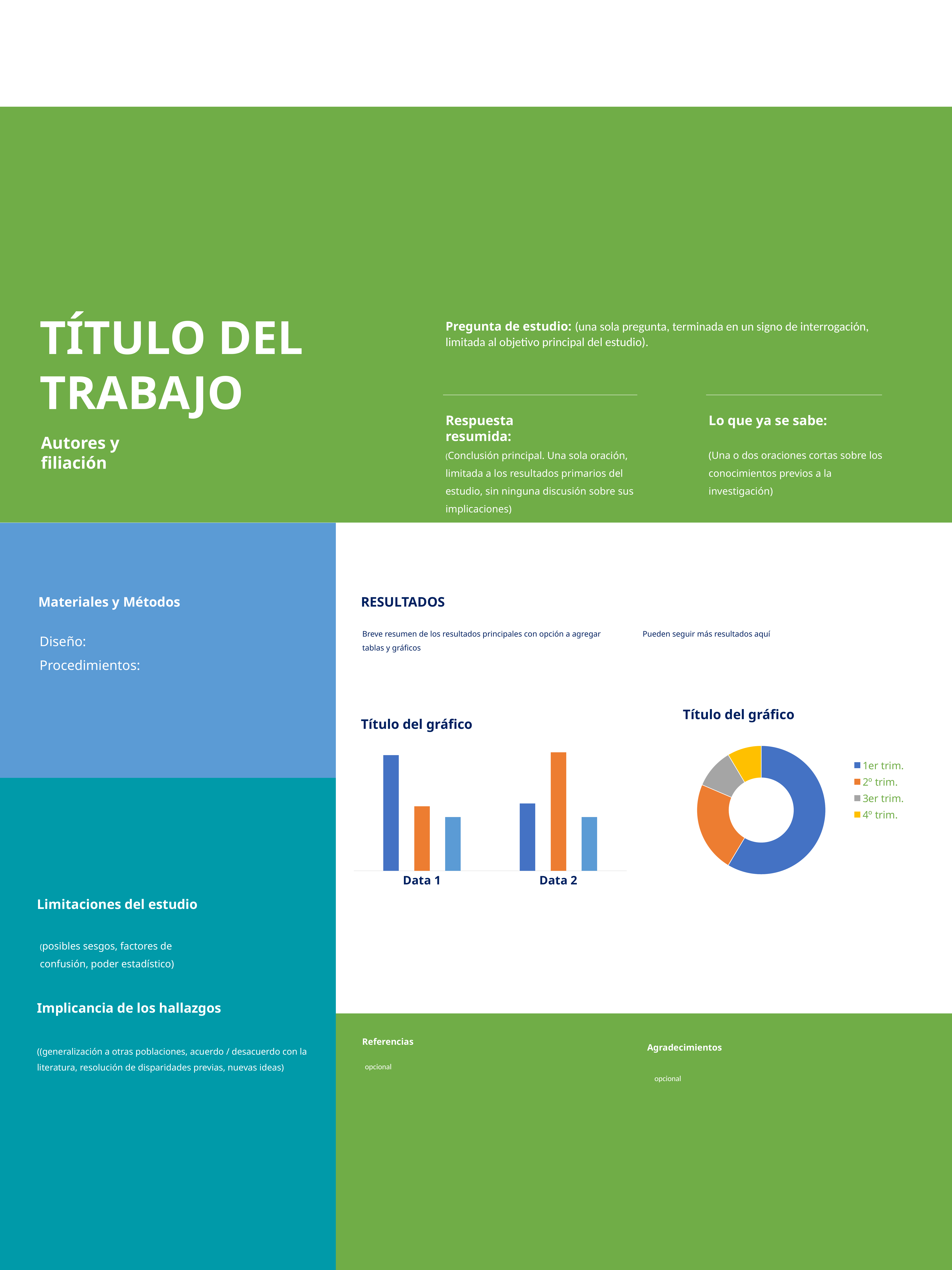
In the doughnut chart on the right, which legend entry has the largest slice? 1er trim. What kind of chart is the chart on the right of the Resultados section? doughnut chart What kind of chart is the chart on the left of the Resultados section? bar chart In the bar chart on the left, is the first (dark blue) bar taller for Data 1 or for Data 2? Data 1 In the bar chart on the left, which bar is tallest within Data 1: the first, second or third? the first In the doughnut chart on the right, which legend entry has the smallest slice? 4º trim. In the bar chart on the left, is the second (orange) bar taller for Data 1 or for Data 2? Data 2 In the doughnut chart on the right, which slice is larger: 2º trim. or 3er trim.? 2º trim. In the bar chart on the left, which category contains the tallest bar overall? Data 2 In the bar chart on the left, how many categories are shown on the x axis? 2 How many entries does the legend of the doughnut chart on the right list? 4 In the bar chart on the left, how many bars are shown for each category? 3